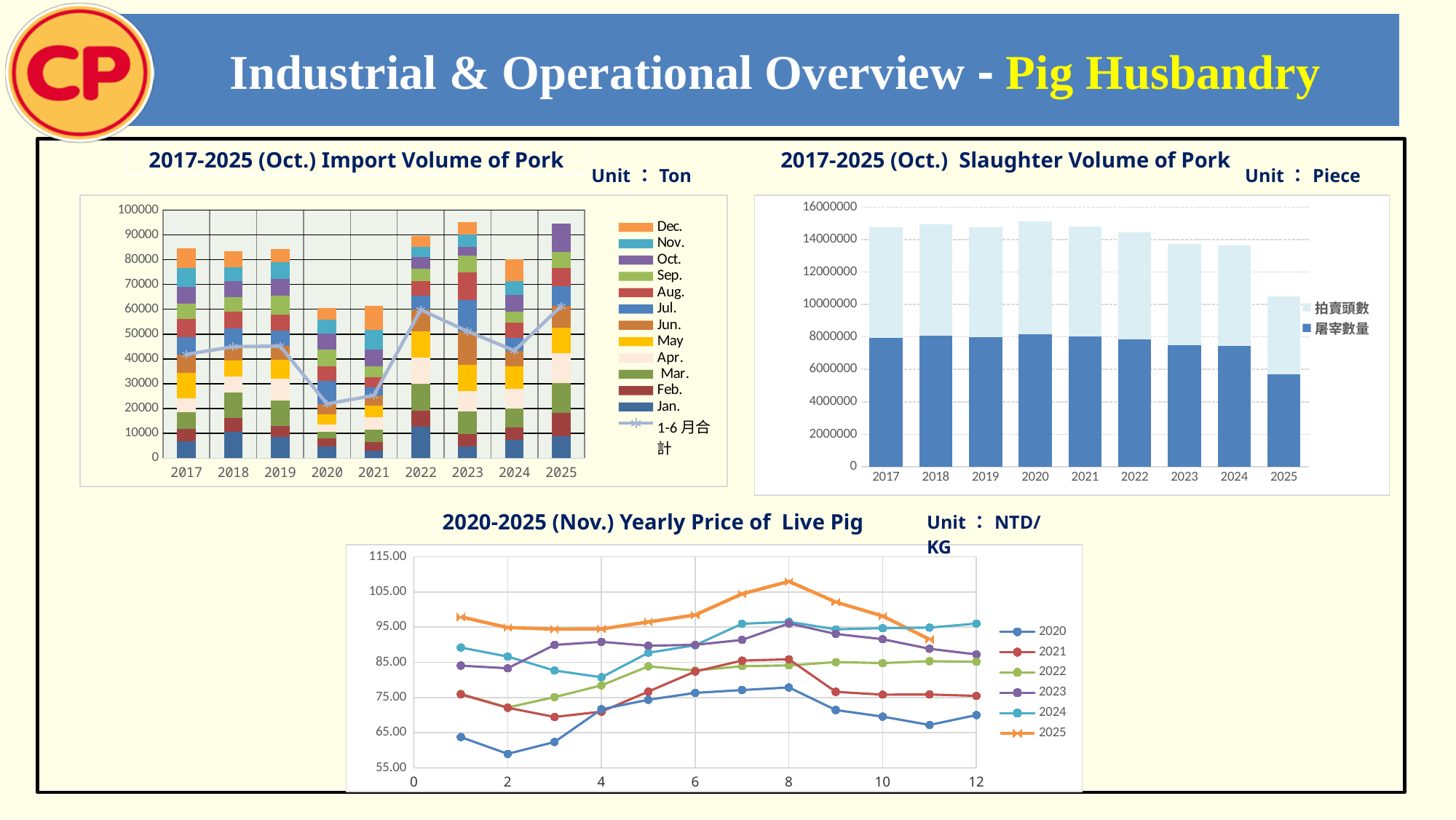
How many entries does the legend of the '2017-2025 (Oct.) Import Volume of Pork' chart list? 13 How many series does the legend of the '2017-2025 (Oct.) Slaughter Volume of Pork' chart list? 2 In the '2017-2025 (Oct.) Import Volume of Pork' chart, how many years are shown on the x axis? 9 What type of chart is the '2020-2025 (Nov.) Yearly Price of Live Pig' chart? line chart In the '2017-2025 (Oct.) Import Volume of Pork' chart, which year has the taller total bar, 2022 or 2024? 2022 How many series does the legend of the '2020-2025 (Nov.) Yearly Price of Live Pig' chart list? 6 What type of chart is the '2017-2025 (Oct.) Slaughter Volume of Pork' chart? bar chart In the '2017-2025 (Oct.) Slaughter Volume of Pork' chart, which year has the lowest total bar? 2025 In the '2017-2025 (Oct.) Slaughter Volume of Pork' chart, is the total bar for 2025 greater or less than 12000000? less In the '2020-2025 (Nov.) Yearly Price of Live Pig' chart, is the 2020 value at month 2 greater or less than 65.00? less In the '2020-2025 (Nov.) Yearly Price of Live Pig' chart, which year's line is highest at month 8? 2025 In the '2017-2025 (Oct.) Import Volume of Pork' chart, is the total stacked bar for 2020 greater or less than 70000? less